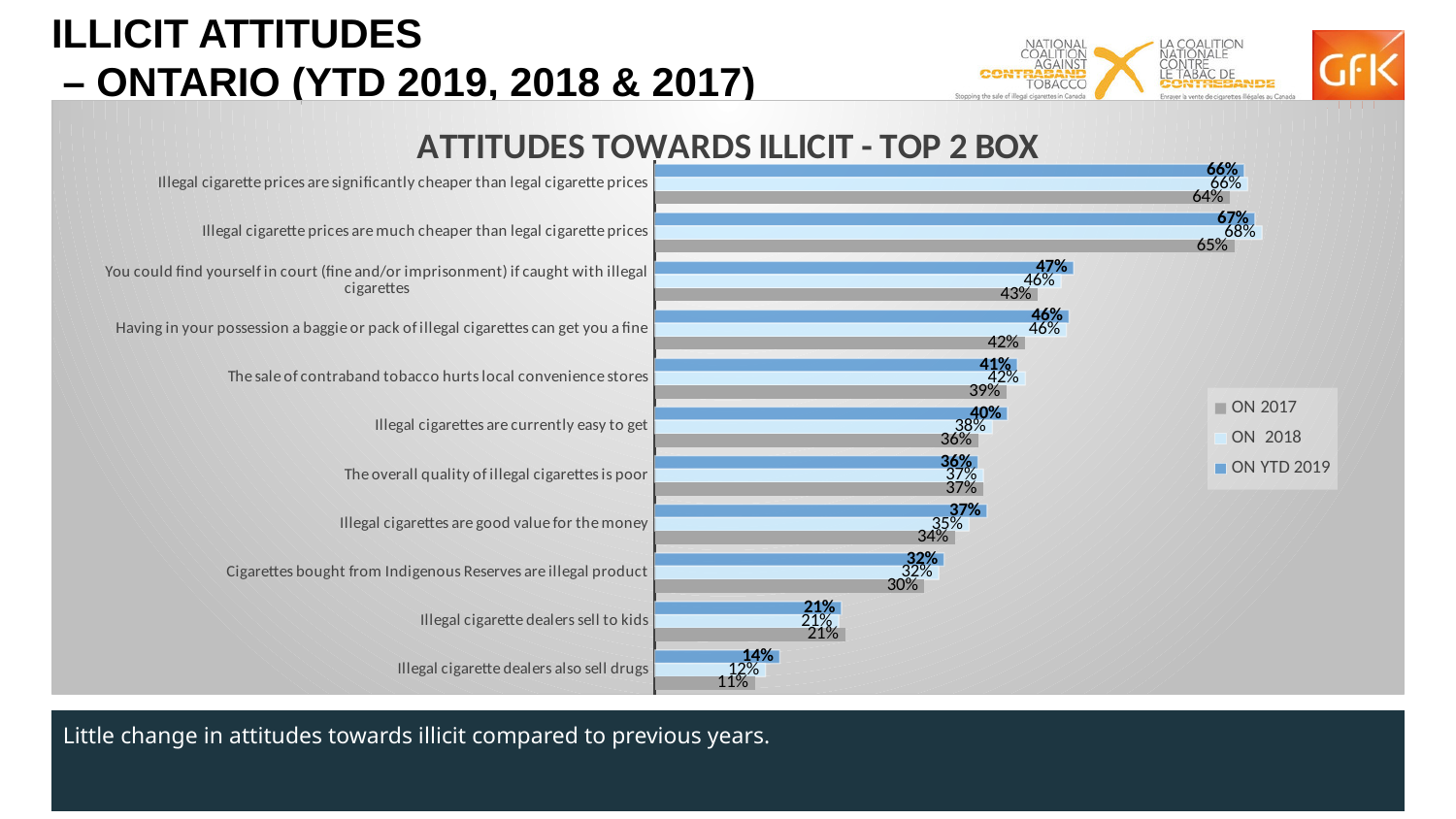
Which statement has the lowest ON 2017 value? Illegal cigarette dealers also sell drugs What is the ON YTD 2019 value for 'Illegal cigarette dealers also sell drugs'? 14% What is the ON 2017 value for 'Illegal cigarette dealers sell to kids'? 21% Which statement has the highest ON YTD 2019 value? Illegal cigarette prices are much cheaper than legal cigarette prices What kind of chart is shown on the slide? bar chart How many series does the legend list? 3 How many attitude statements (categories) are plotted in the chart? 11 What is the ON 2018 value for 'Illegal cigarettes are currently easy to get'? 38% What is the difference between the ON YTD 2019 and ON 2017 values for 'You could find yourself in court (fine and/or imprisonment) if caught with illegal cigarettes'? 4% For 'Illegal cigarettes are good value for the money', which is larger: the ON YTD 2019 value or the ON 2017 value? ON YTD 2019 What is the title of the chart? ATTITUDES TOWARDS ILLICIT - TOP 2 BOX What is the ON 2017 value for 'Illegal cigarette prices are much cheaper than legal cigarette prices'? 65%